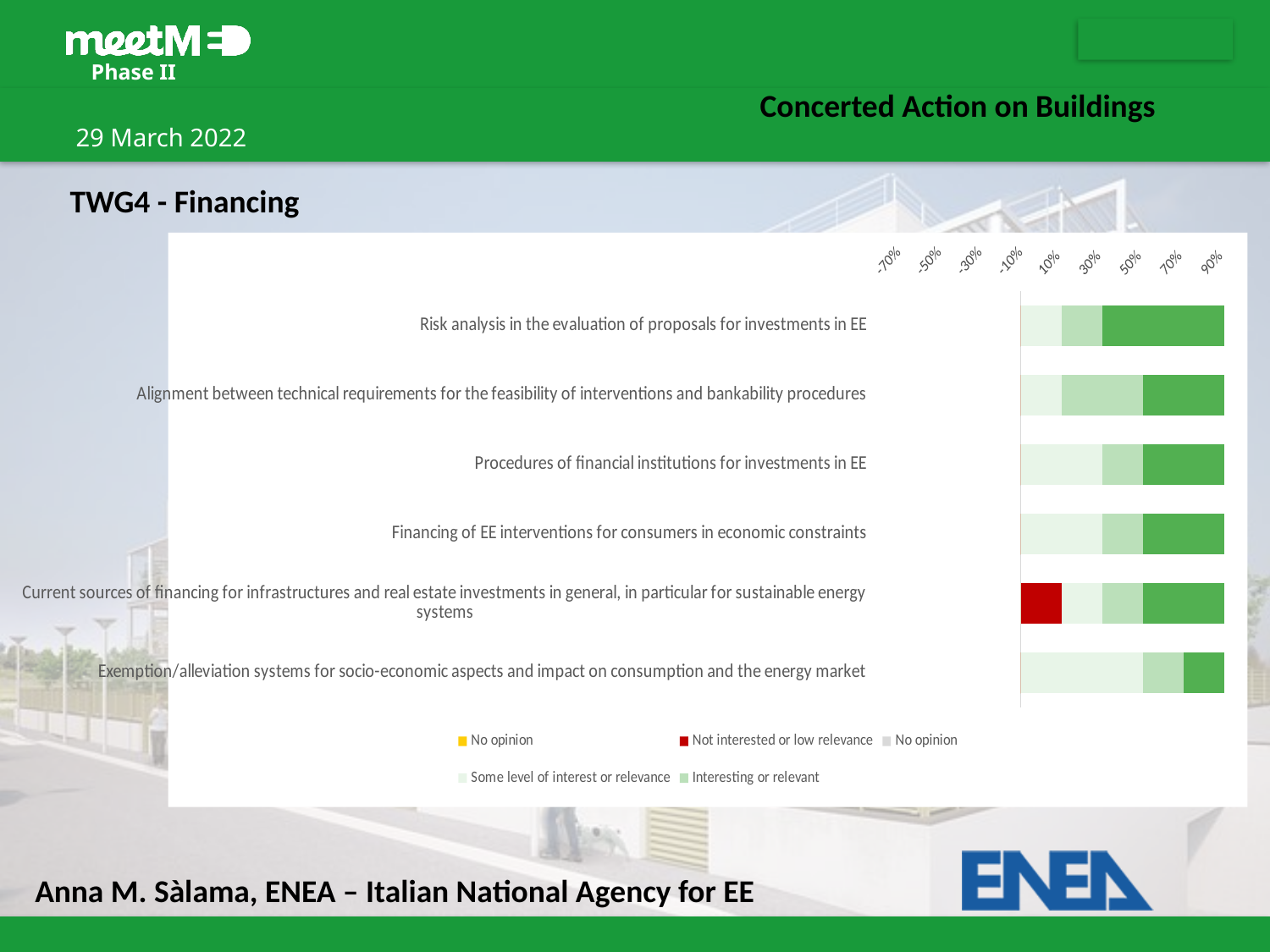
How many categories (topics) are plotted in the chart? 6 What kind of chart is shown on the slide? Stacked horizontal bar chart Which category has a 'Not interested or low relevance' (red) segment? Current sources of financing for infrastructures and real estate investments in general, in particular for sustainable energy systems How many entries does the chart legend list? 5 What is the lowest value shown on the chart's percentage axis? -70% Which category has the largest 'Some level of interest or relevance' segment? Exemption/alleviation systems for socio-economic aspects and impact on consumption and the energy market Which category has the largest 'Interesting or relevant' segment? Alignment between technical requirements for the feasibility of interventions and bankability procedures What colour represents 'Not interested or low relevance' in the legend? Red Which category is listed at the top of the chart? Risk analysis in the evaluation of proposals for investments in EE